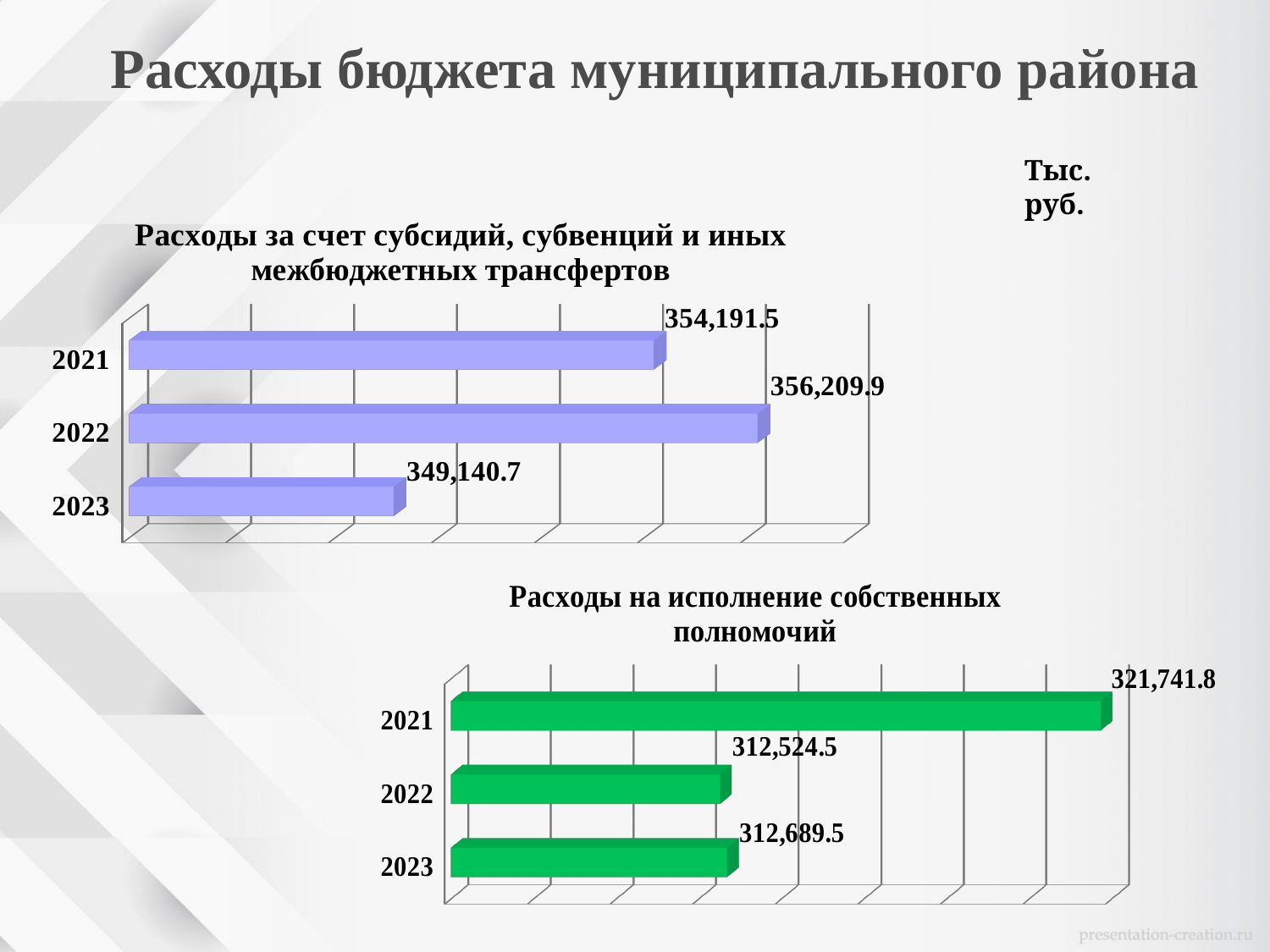
In the bottom chart (Расходы на исполнение собственных полномочий), which is larger: the value for 2021 or the value for 2023? 2021 In the top chart (Расходы за счет субсидий, субвенций и иных межбюджетных трансфертов), what is the value for 2022? 356,209.9 In the top chart (Расходы за счет субсидий, субвенций и иных межбюджетных трансфертов), what is the difference between the 2022 and 2023 values? 7,069.2 In the top chart (Расходы за счет субсидий, субвенций и иных межбюджетных трансфертов), what is the value for 2023? 349,140.7 In the top chart (Расходы за счет субсидий, субвенций и иных межбюджетных трансфертов), which year has the lowest value? 2023 In the bottom chart (Расходы на исполнение собственных полномочий), which year has the lowest value? 2022 In the bottom chart (Расходы на исполнение собственных полномочий), which year has the highest value? 2021 In the top chart (Расходы за счет субсидий, субвенций и иных межбюджетных трансфертов), which year has the highest value? 2022 In the bottom chart (Расходы на исполнение собственных полномочий), what is the difference between the 2021 and 2022 values? 9,217.3 In the bottom chart (Расходы на исполнение собственных полномочий), what is the value for 2021? 321,741.8 What type of chart is the top chart (Расходы за счет субсидий, субвенций и иных межбюджетных трансфертов)? Bar chart In the bottom chart (Расходы на исполнение собственных полномочий), what is the value for 2022? 312,524.5